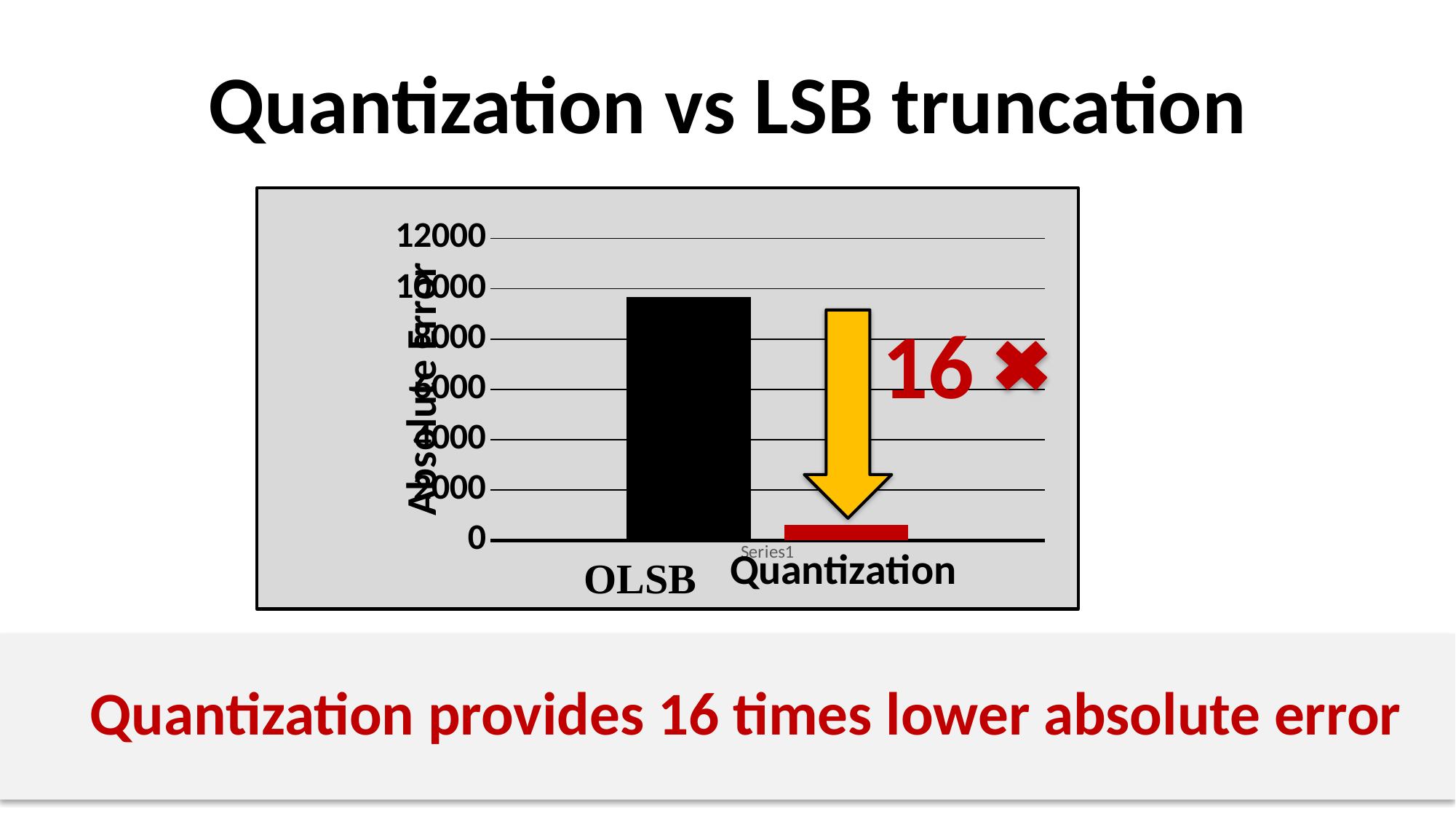
What is the label on the vertical axis of the chart? Absolute Error What is the highest tick value shown on the vertical axis? 12000 Which category has the lowest absolute error? Quantization What colour is the bar for Quantization? red Is the value for Quantization greater or less than 2000? less Is the value for OLSB greater or less than 10000? less Is the value for OLSB greater or less than 8000? greater How many bars are plotted in the chart? 2 Which category has the highest absolute error? OLSB What kind of chart is shown on the slide? bar chart Which has a larger absolute error, OLSB or Quantization? OLSB Do the bar values rise or fall from OLSB to Quantization? fall